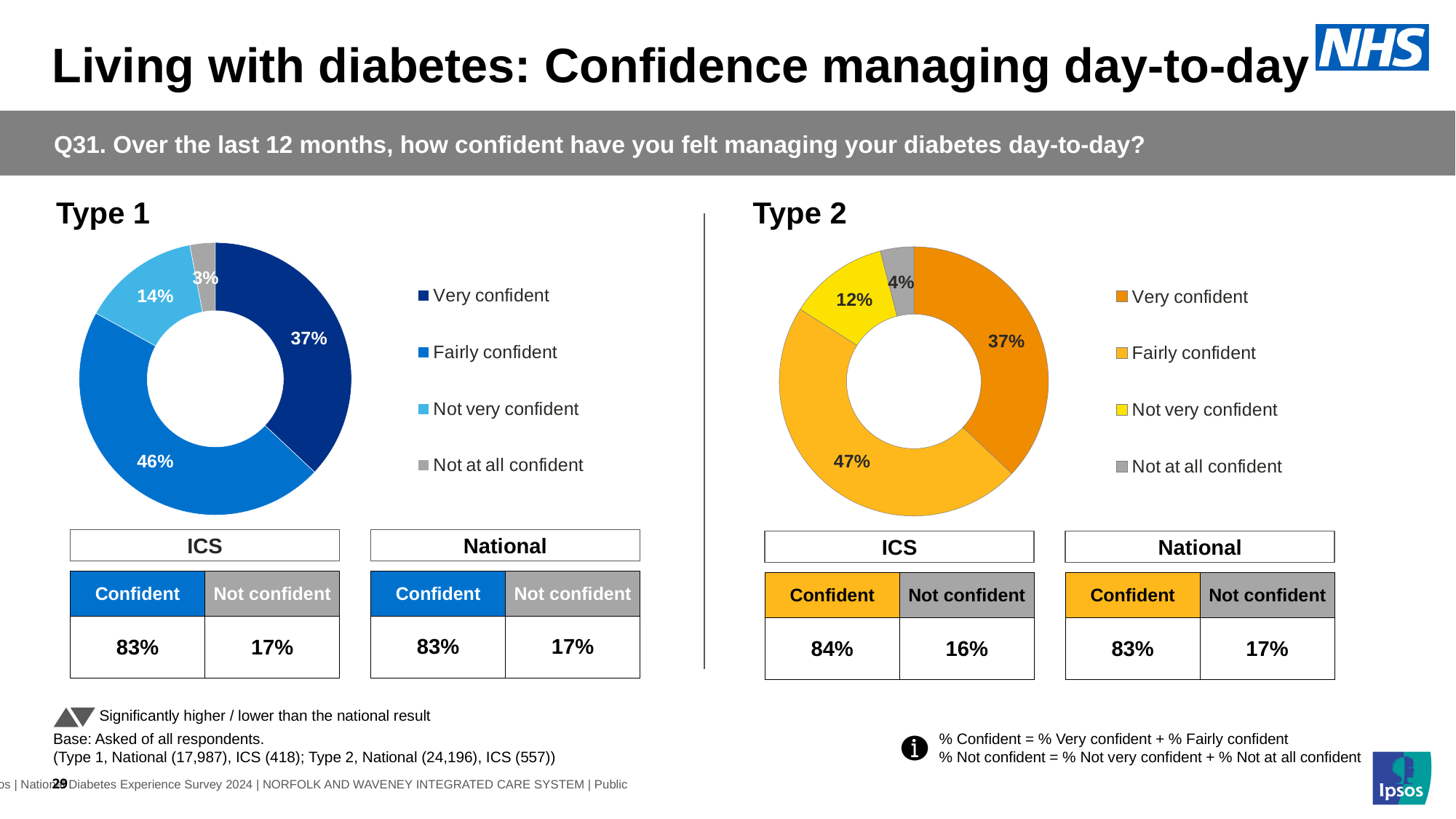
In the Type 2 chart, what percentage of respondents were not very confident? 12% In the Type 1 chart, what percentage of respondents were not at all confident? 3% In the Type 2 chart, what is the combined share of very confident and fairly confident? 84% In the Type 1 chart, what colour represents the very confident category? Dark blue In the Type 1 chart, what percentage of respondents were fairly confident? 46% How many categories does the Type 1 chart show? 4 In the Type 2 chart, what percentage of respondents were very confident? 37% In the Type 2 chart, which category has the largest share? Fairly confident In the Type 1 chart, which category has the smallest share? Not at all confident In the Type 1 chart, what is the difference between the fairly confident and very confident shares? 9% In the Type 2 chart, which is larger: the not very confident share or the not at all confident share? Not very confident What kind of chart is used for Type 2? Doughnut chart